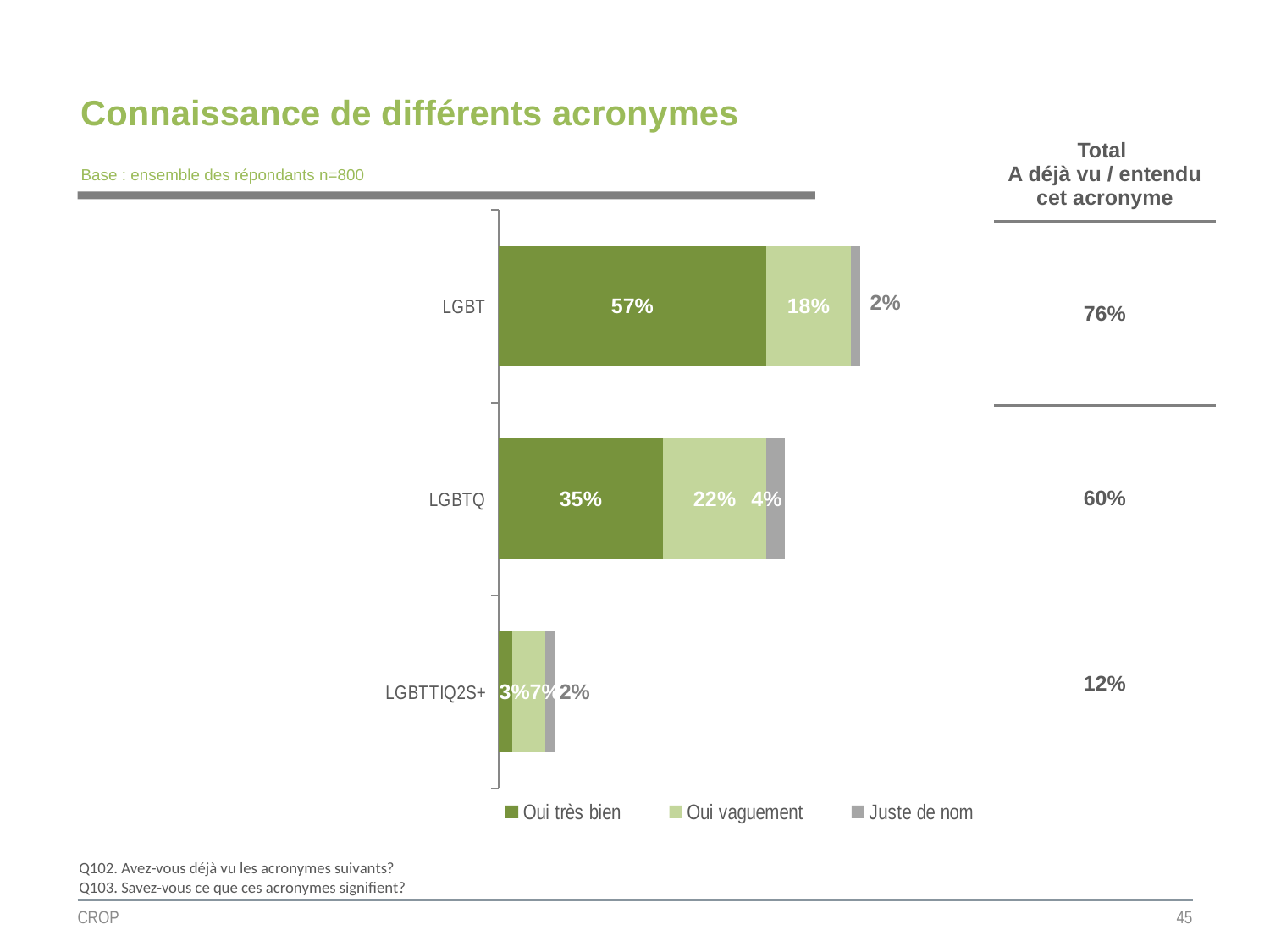
What is the "Total A déjà vu / entendu cet acronyme" value shown for LGBTQ? 60% Which acronym has the lowest "Oui vaguement" value? LGBTTIQ2S+ How many acronyms are shown in the chart? 3 What percentage of respondents answered "Oui très bien" for LGBT? 57% What kind of chart is shown on the slide? Stacked bar chart What is the "Juste de nom" value for LGBTTIQ2S+? 2% What is the "Oui vaguement" value for LGBTQ? 22% What is the total of the stacked bar for LGBTTIQ2S+? 12% Which acronym has the highest "Oui très bien" value? LGBT What is the difference between the "Oui très bien" values for LGBT and LGBTQ? 22 percentage points Which is larger: the "Juste de nom" value for LGBTQ or for LGBT? LGBTQ How many series does the legend list? 3